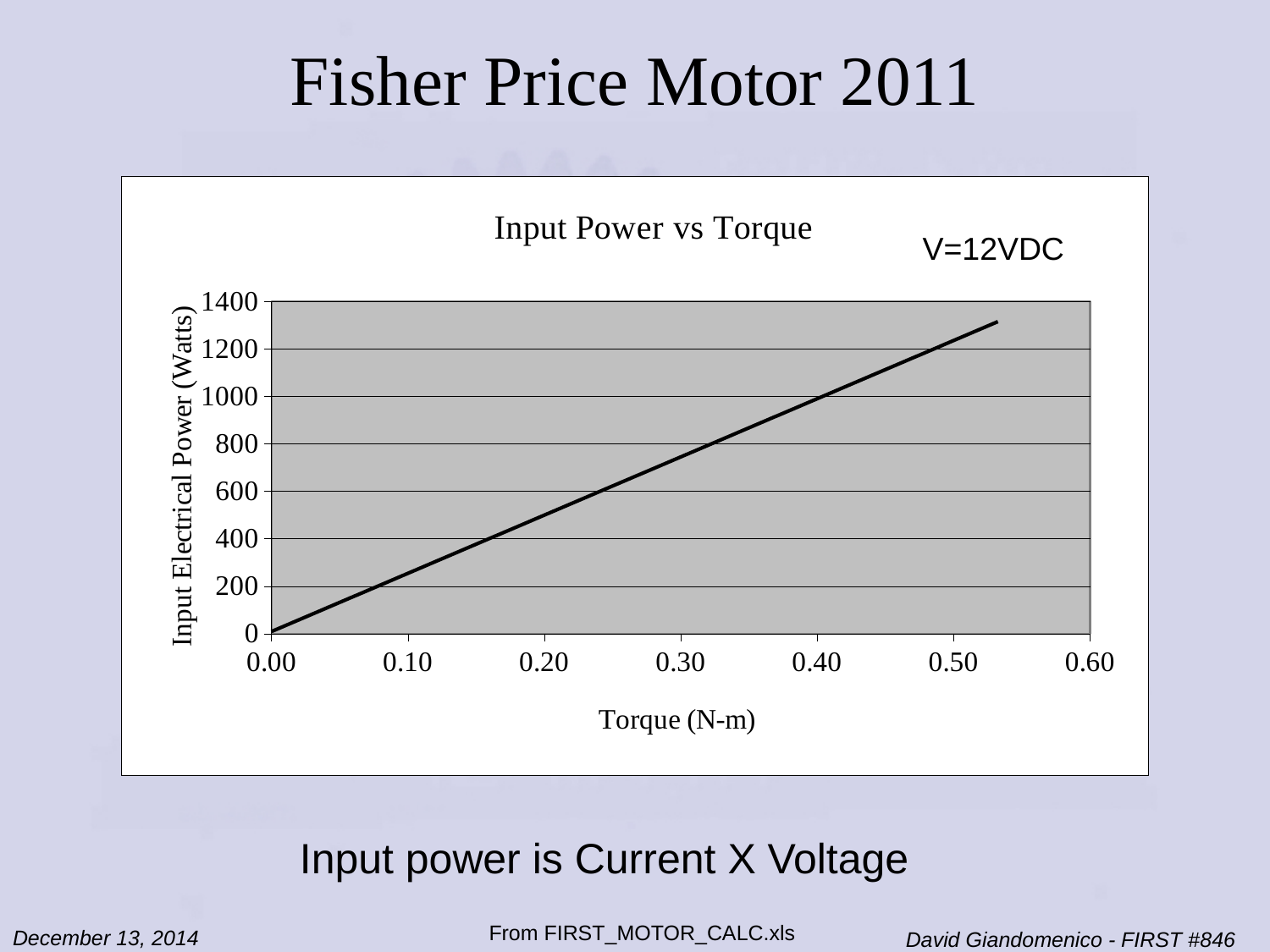
Which torque has the higher input electrical power, 0.10 N-m or 0.40 N-m? 0.40 N-m Is the highest input electrical power plotted on the chart greater or less than 1400? less What is the title of the chart? Input Power vs Torque Is the input electrical power at a torque of 0.20 N-m greater or less than 400? greater Is the input electrical power at a torque of 0.20 N-m greater or less than 600? less What is the label of the y axis of the chart? Input Electrical Power (Watts) Does the input electrical power rise or fall as torque increases along the x axis? rises What kind of chart is shown on the slide? line chart